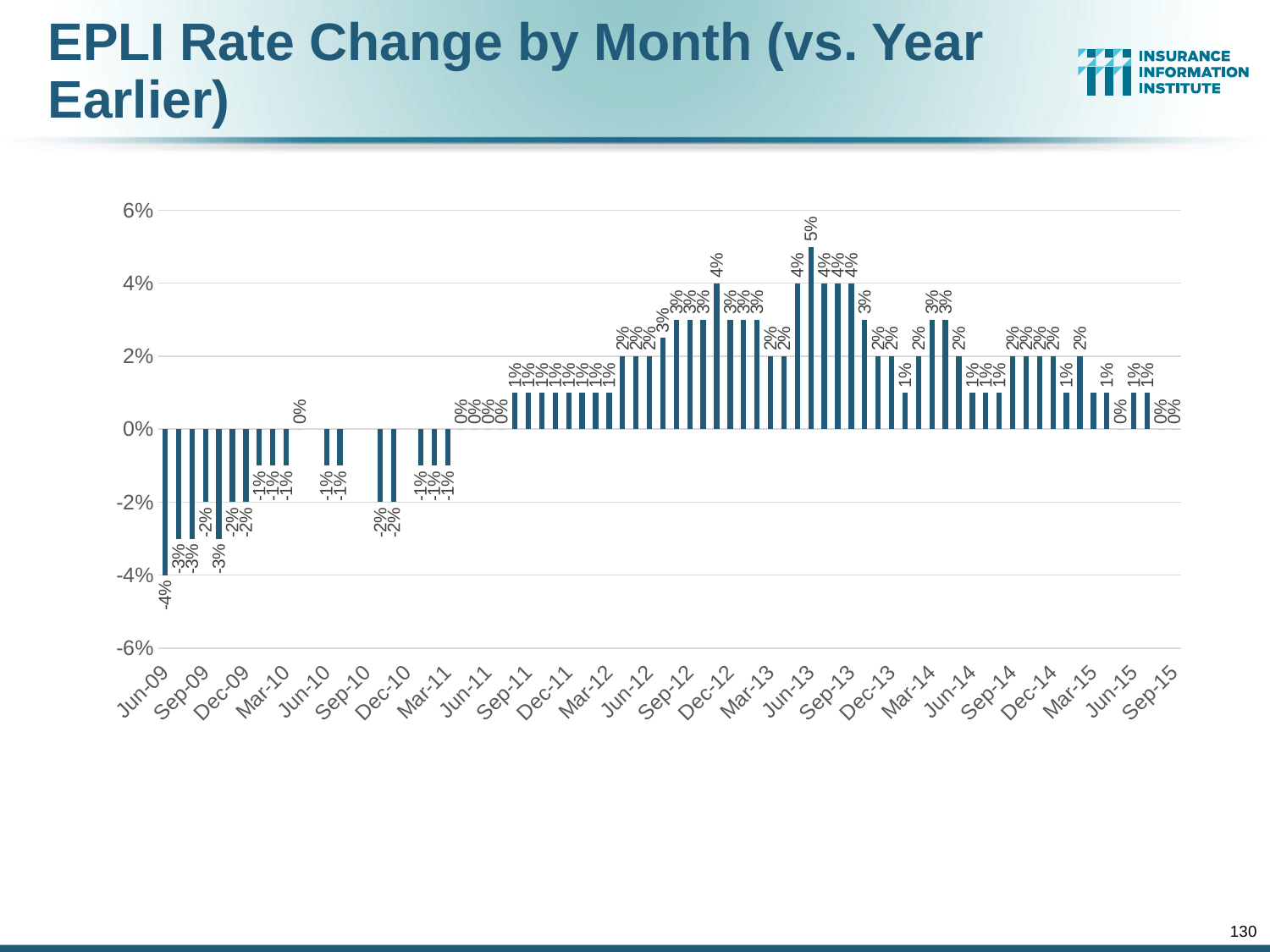
Is the rate change for Jun-13 greater or less than 4%? greater Does the EPLI rate change generally rise or fall from Jun-09 to Jun-13? rise What is the EPLI rate change for Sep-15, the last month on the chart? 0% Which is larger, the rate change for Jun-09 or the rate change for Jun-13? Jun-13 In which month does the EPLI rate change reach its peak of 5%? Jun-13 What is the title of the chart on the slide? EPLI Rate Change by Month (vs. Year Earlier) What is the lowest EPLI rate change value shown on the chart? -4% What type of chart is shown on the slide? bar chart What are the minimum and maximum values shown on the vertical axis? -6% and 6% What is the difference in percentage points between the highest value (5%) and the lowest value (-4%) on the chart? 9 percentage points What is the highest EPLI rate change value shown on the chart? 5% What is the EPLI rate change for Jun-09, the first month on the chart? -4%